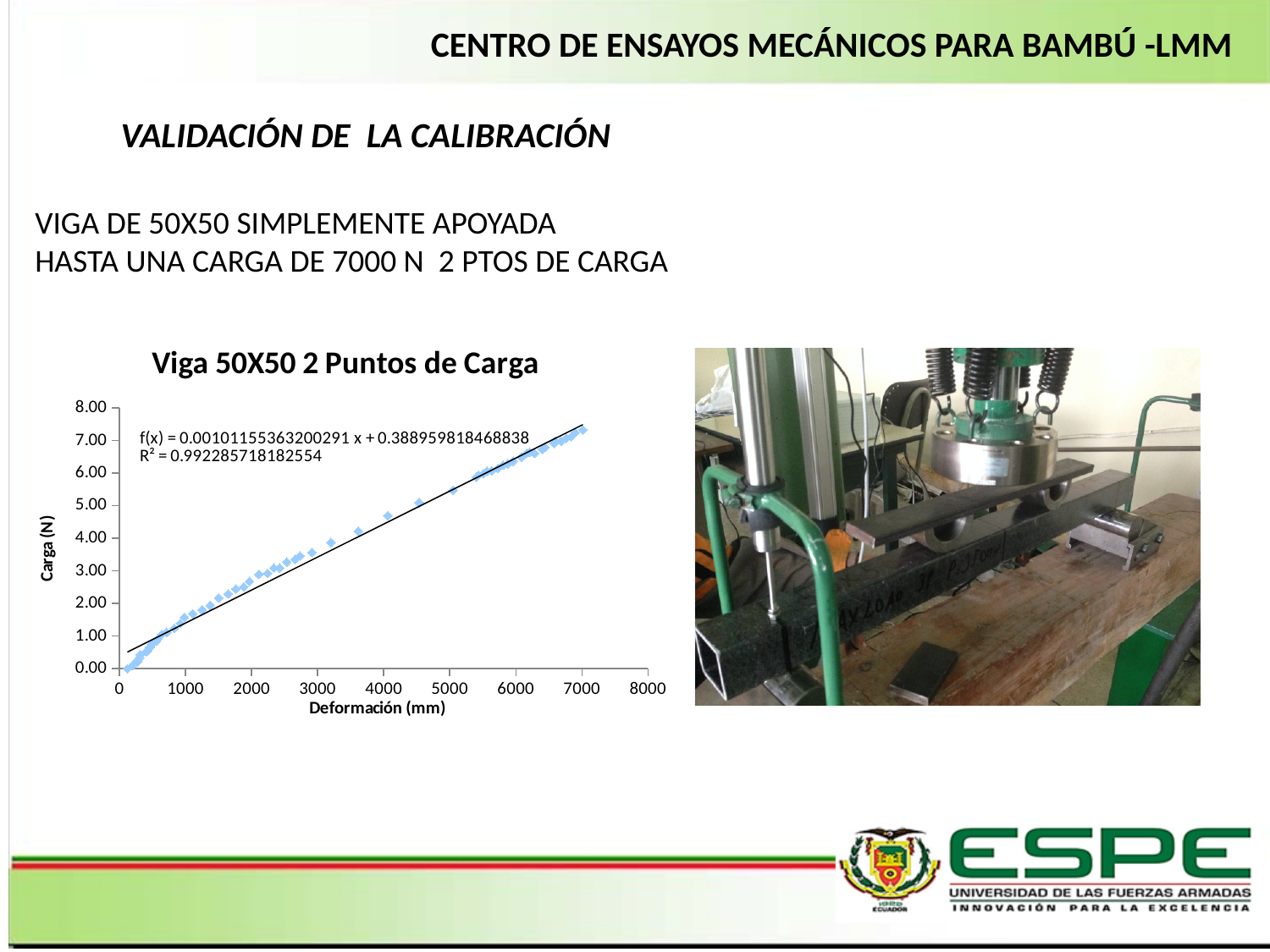
What is the highest value shown on the y axis (Carga) of the chart? 8.00 Is the Carga value of the rightmost plotted point (near 7000 mm deformation) greater or less than 6.00? greater What is the highest value shown on the x axis (Deformación) of the chart? 8000 Do the plotted values rise or fall as Deformación increases along the x axis? rise Is the Carga value of the plotted point near 4000 mm deformation greater or less than 6.00? less What R² value is printed on the chart? 0.992285718182554 What is the title of the chart? Viga 50X50 2 Puntos de Carga What kind of chart is shown on the slide? scatter chart What is the label of the x axis of the chart? Deformación (mm) Is the Carga value of the plotted point near 1000 mm deformation greater or less than 3.00? less What trendline equation is printed on the chart? f(x) = 0.00101155363200291 x + 0.388959818468838 Which has the larger Carga value: the plotted point near 2000 mm deformation or the plotted point near 6000 mm deformation? the point near 6000 mm